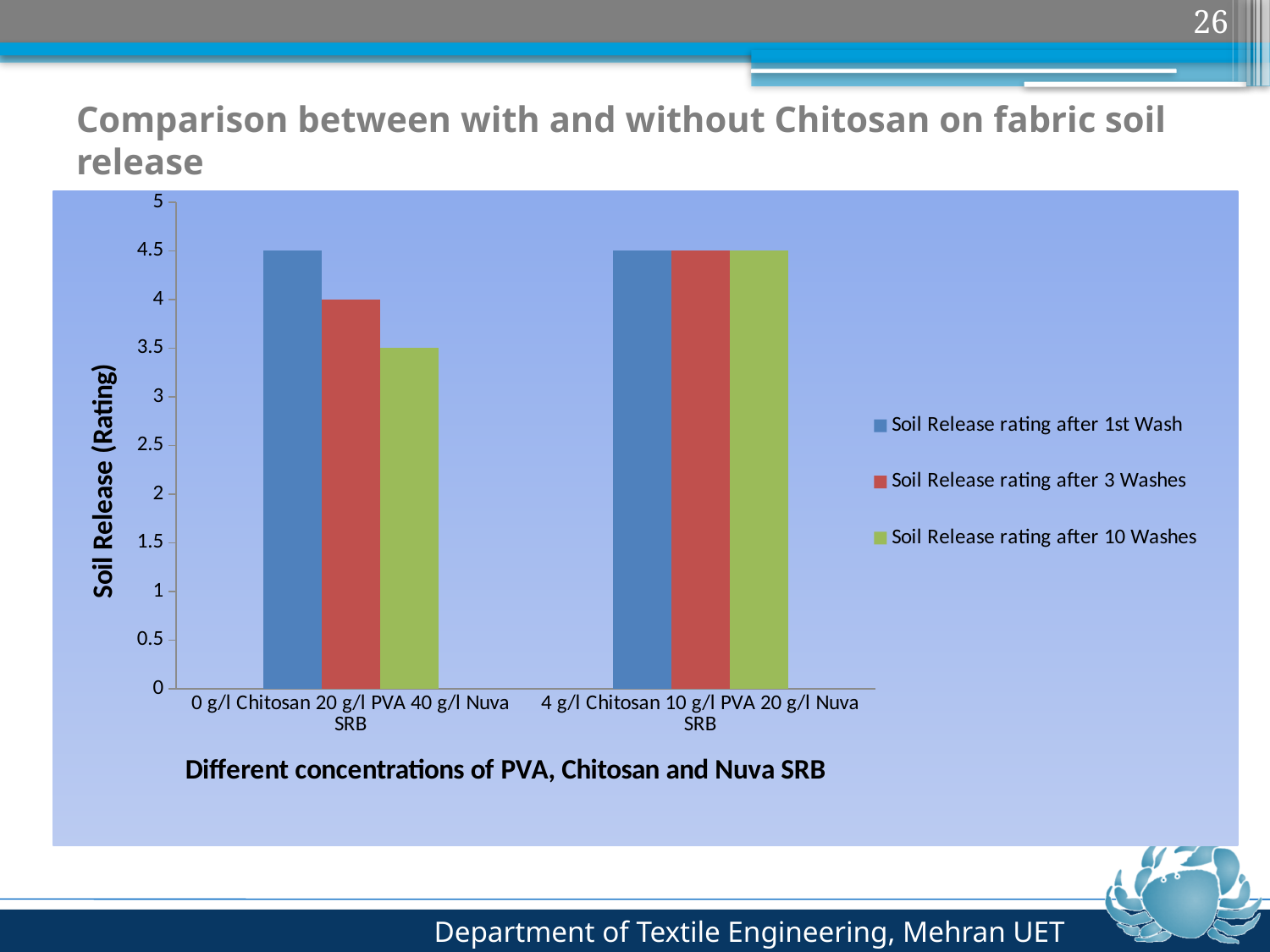
Which category has the lowest Soil Release rating after 10 Washes? 0 g/l Chitosan 20 g/l PVA 40 g/l Nuva SRB What is the Soil Release rating after 3 Washes for 0 g/l Chitosan 20 g/l PVA 40 g/l Nuva SRB? 4 Is the Soil Release rating after 10 Washes for 0 g/l Chitosan 20 g/l PVA 40 g/l Nuva SRB greater or less than 4? less What kind of chart is shown on the slide? bar chart How many categories are shown on the x axis? 2 What is the difference between the Soil Release rating after 1st Wash and after 10 Washes for 0 g/l Chitosan 20 g/l PVA 40 g/l Nuva SRB? 1 What is the Soil Release rating after 1st Wash for 4 g/l Chitosan 10 g/l PVA 20 g/l Nuva SRB? 4.5 What is the Soil Release rating after 10 Washes for 0 g/l Chitosan 20 g/l PVA 40 g/l Nuva SRB? 3.5 Which is larger for 0 g/l Chitosan 20 g/l PVA 40 g/l Nuva SRB: the Soil Release rating after 3 Washes or after 10 Washes? after 3 Washes What is the Soil Release rating after 10 Washes for 4 g/l Chitosan 10 g/l PVA 20 g/l Nuva SRB? 4.5 What is the label of the y axis? Soil Release (Rating) How many series does the legend list? 3